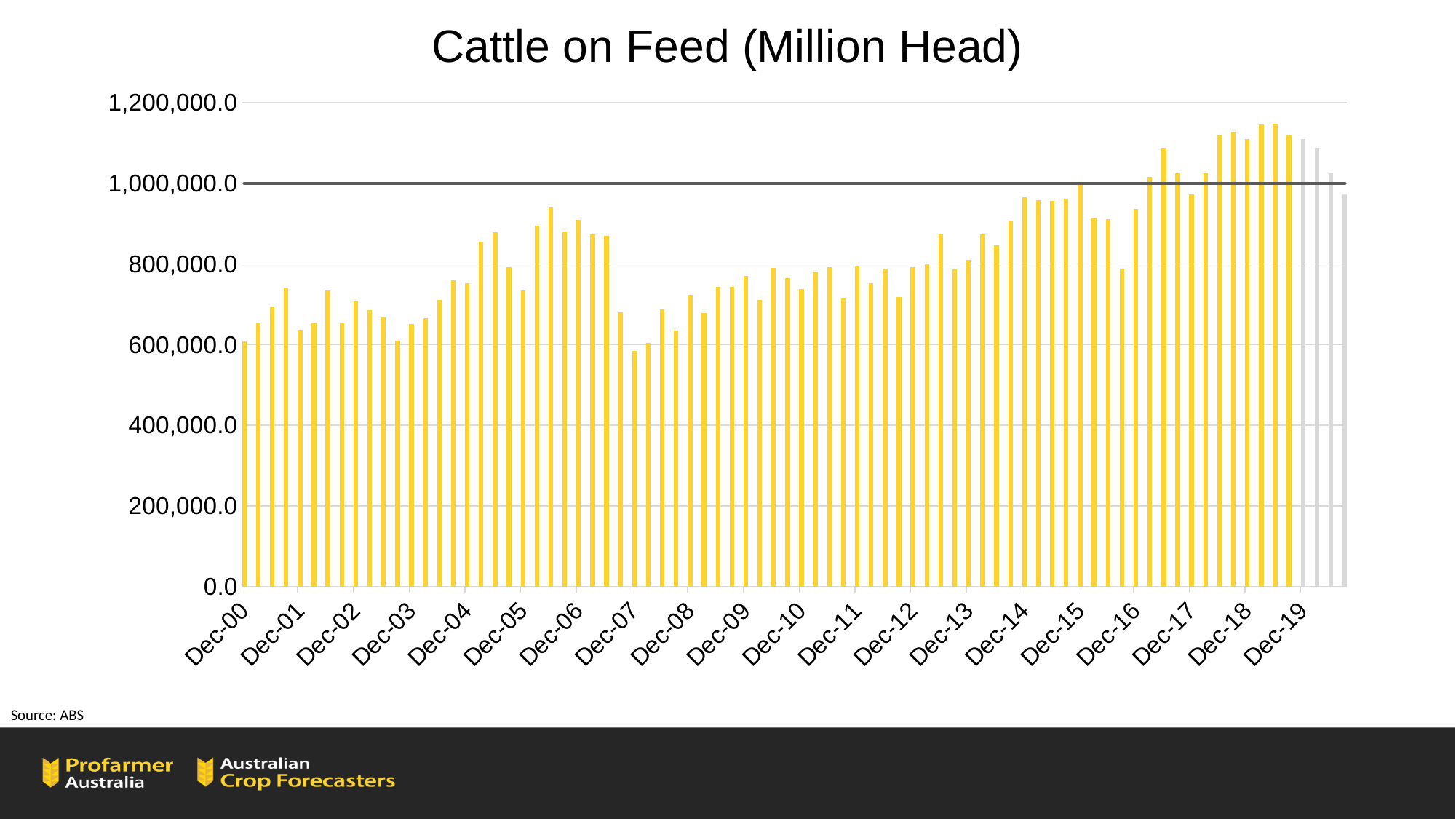
What kind of chart is shown on the slide? Bar chart Is the value for Dec-06 greater or less than 800,000.0? greater What is the source cited for the chart? ABS Overall, do the values rise or fall from Dec-00 to Dec-19? rise Is the value for Dec-07 greater or less than 800,000.0? less Is the value for Dec-04 greater or less than 800,000.0? less How many year labels are shown on the x axis, from Dec-00 to Dec-19? 20 Which is larger, the value for Dec-18 or the value for Dec-03? Dec-18 What is the title of the chart? Cattle on Feed (Million Head)